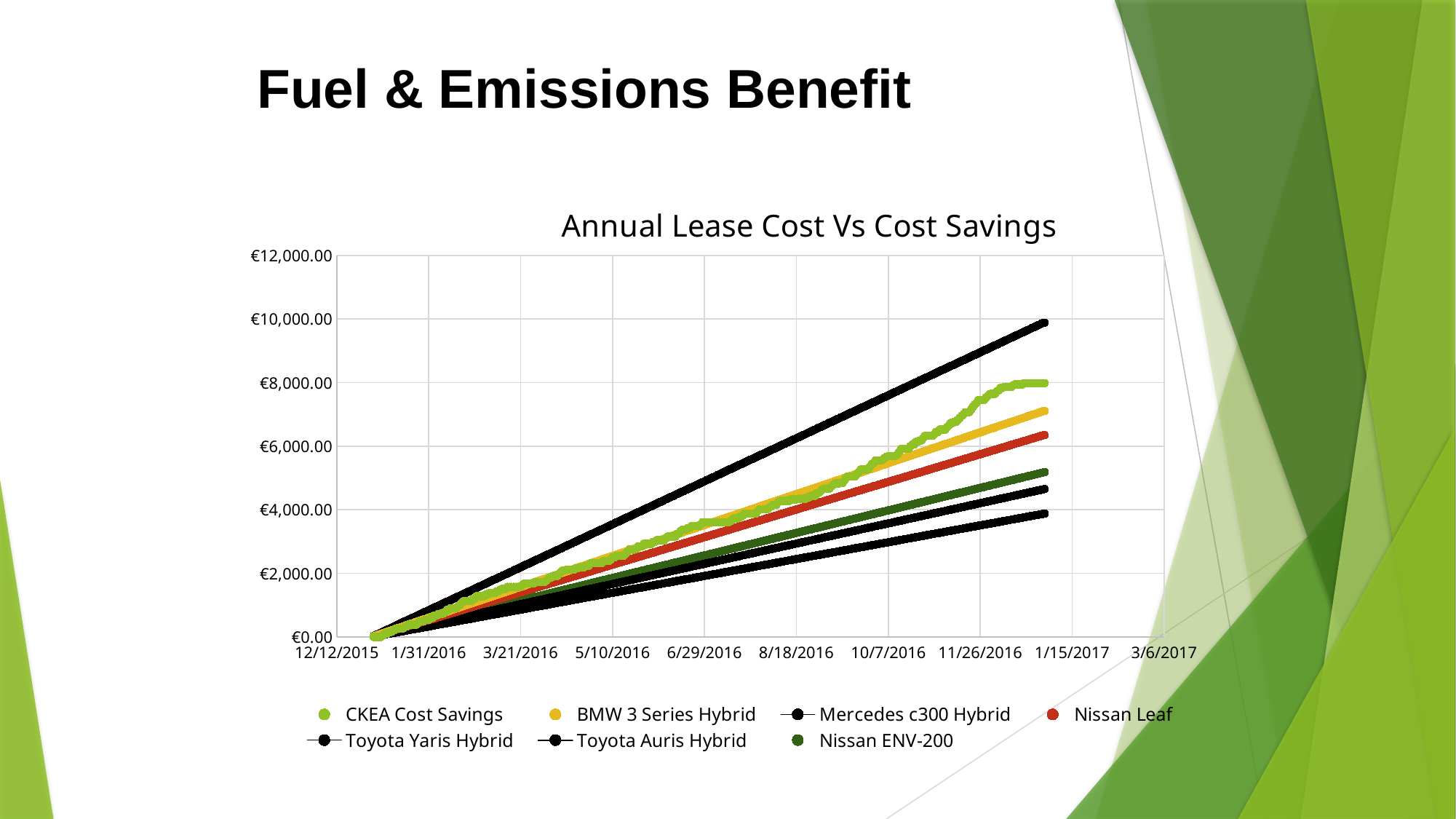
What kind of chart is shown on the slide? line chart What colour is used for the Nissan Leaf series? red Is the final value of the Nissan Leaf series greater or less than €4,000.00? greater At the end of the period, which is higher: Nissan Leaf or Nissan ENV-200? Nissan Leaf At the end of the period, which is higher: BMW 3 Series Hybrid or Nissan Leaf? BMW 3 Series Hybrid At the end of the period, which is higher: CKEA Cost Savings or BMW 3 Series Hybrid? CKEA Cost Savings Is the final value of the CKEA Cost Savings series greater or less than €6,000.00? greater Does the CKEA Cost Savings series rise or fall over time along the x axis? rise How many series does the chart legend list? 7 Is the final value of the BMW 3 Series Hybrid series greater or less than €6,000.00? greater What is the title of the chart? Annual Lease Cost Vs Cost Savings